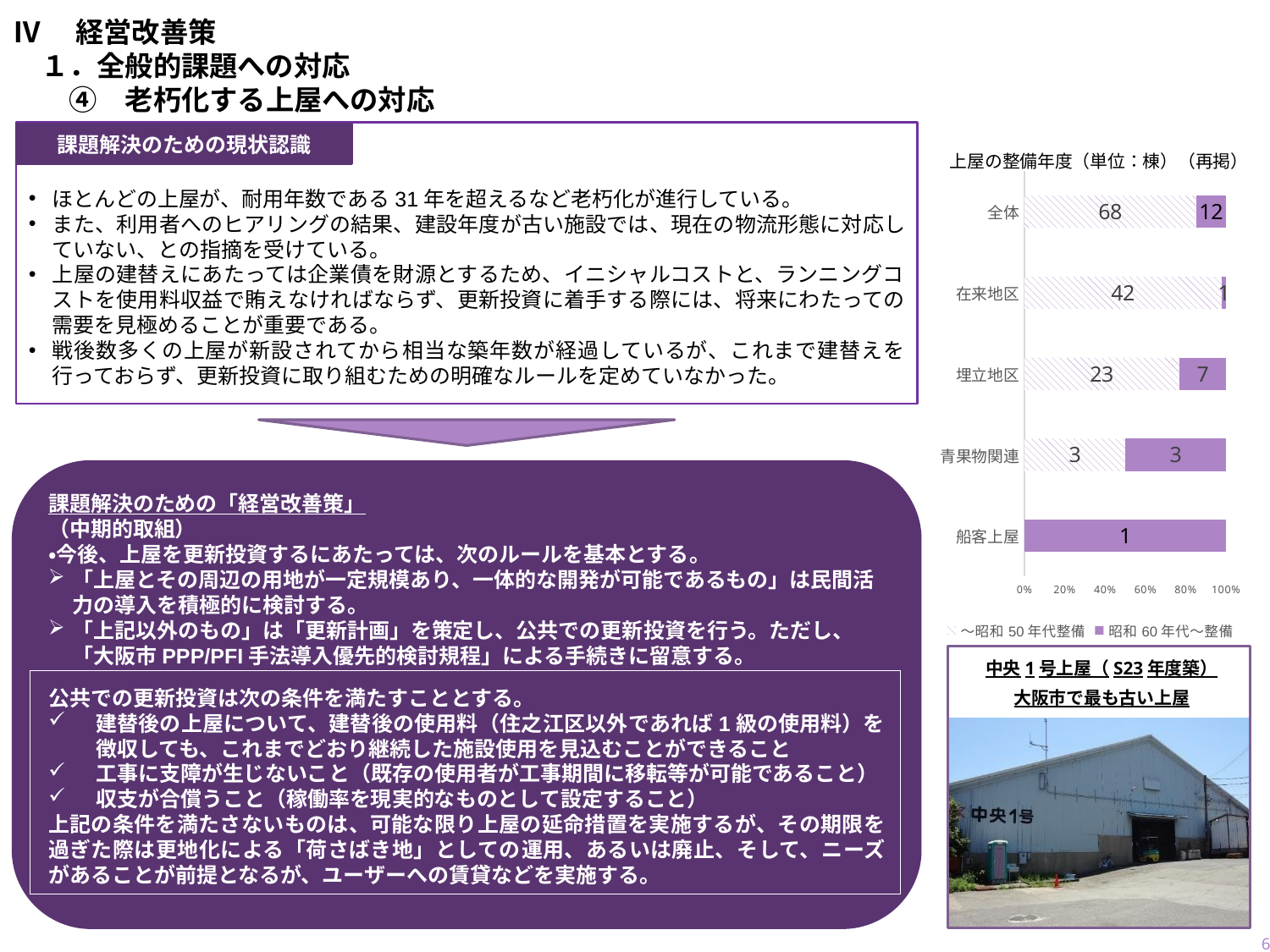
What is the total of the 埋立地区 bar across both series? 30 What is the value for 全体 in the ～昭和50年代整備 series? 68 How many categories are shown on the chart? 5 What is the value for 埋立地区 in the 昭和60年代～整備 series? 7 What kind of chart is shown on the slide? Stacked bar chart What is the value for 青果物関連 in the ～昭和50年代整備 series? 3 What is the value for 船客上屋 in the 昭和60年代～整備 series? 1 Which category has the highest value in the ～昭和50年代整備 series? 全体 What is the value for 在来地区 in the ～昭和50年代整備 series? 42 How many series does the legend list? 2 What is the value for 全体 in the 昭和60年代～整備 series? 12 What is the difference between the ～昭和50年代整備 and 昭和60年代～整備 values for 在来地区? 41